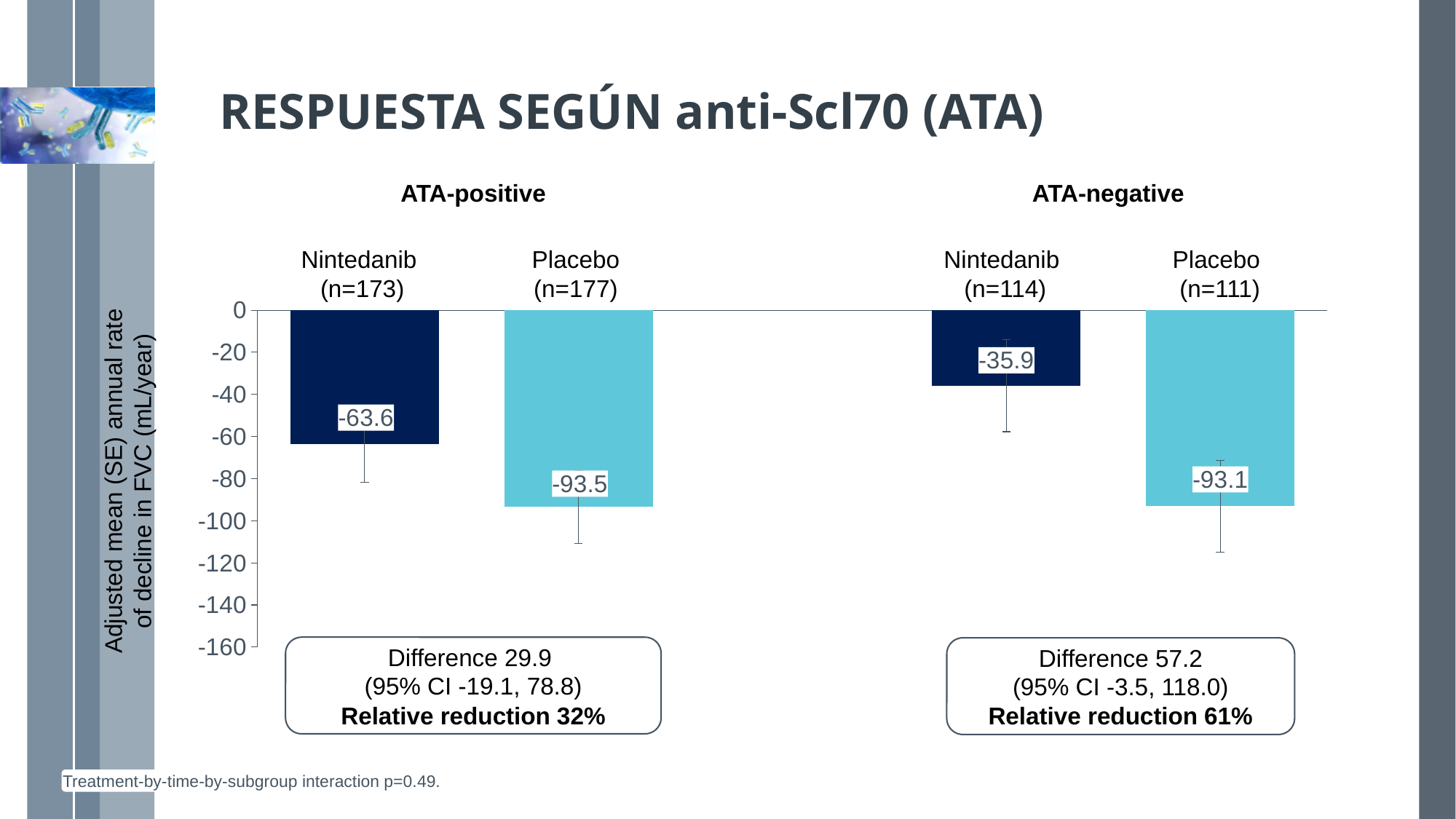
What is the difference between the Nintedanib and Placebo values in the ATA-positive group, as printed on the slide? 29.9 What is the adjusted mean annual rate of decline in FVC for Placebo in the ATA-negative group? -93.1 What kind of chart is shown on the slide? Bar chart What is the adjusted mean annual rate of decline in FVC for Nintedanib in the ATA-positive group? -63.6 What is the difference between the Nintedanib and Placebo values in the ATA-negative group, as printed on the slide? 57.2 What is the value shown for Nintedanib in the ATA-negative group? -35.9 Which bar shows the smallest decline in FVC (the value closest to zero)? Nintedanib (ATA-negative) Which bar shows the largest decline in FVC (the most negative value)? Placebo (ATA-positive) What is the relative reduction reported for the ATA-negative group? 61% Which has a smaller decline in FVC: Nintedanib in the ATA-positive group or Nintedanib in the ATA-negative group? Nintedanib in the ATA-negative group How many bars are plotted in the chart? 4 What is the value shown for Placebo in the ATA-positive group? -93.5